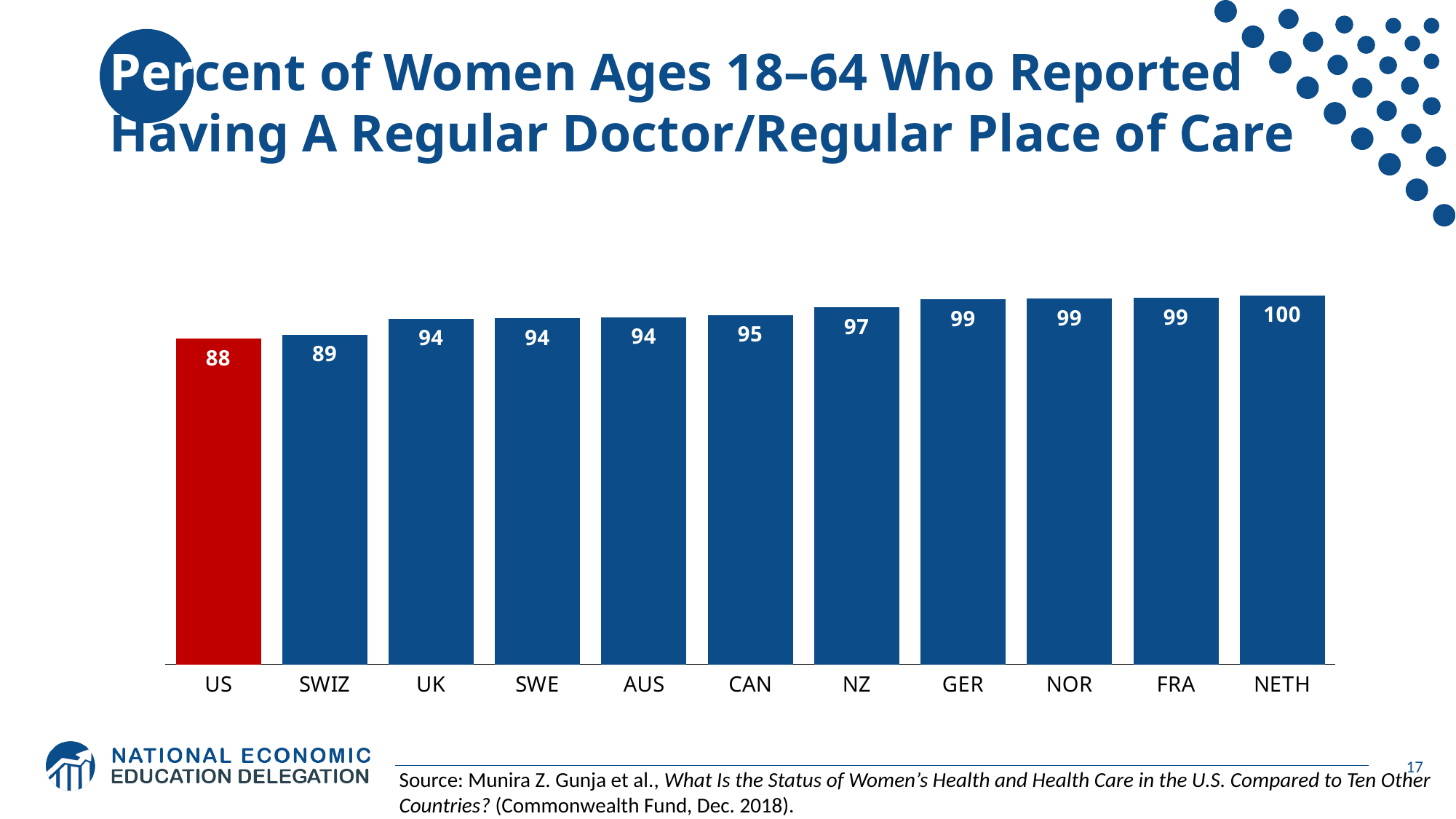
How many countries are shown in the chart? 11 What is the value for NZ? 97 Which has a larger value, UK or NZ? NZ Which country has the lowest value? US What is the difference between the values for SWIZ and the US? 1 What kind of chart is shown on the slide? bar chart What is the value for CAN? 95 Do the values rise or fall from left to right along the x axis? rise What is the value for the US? 88 What is the difference between the values for NETH and the US? 12 Which country's bar is coloured red? US Which country has the highest value? NETH